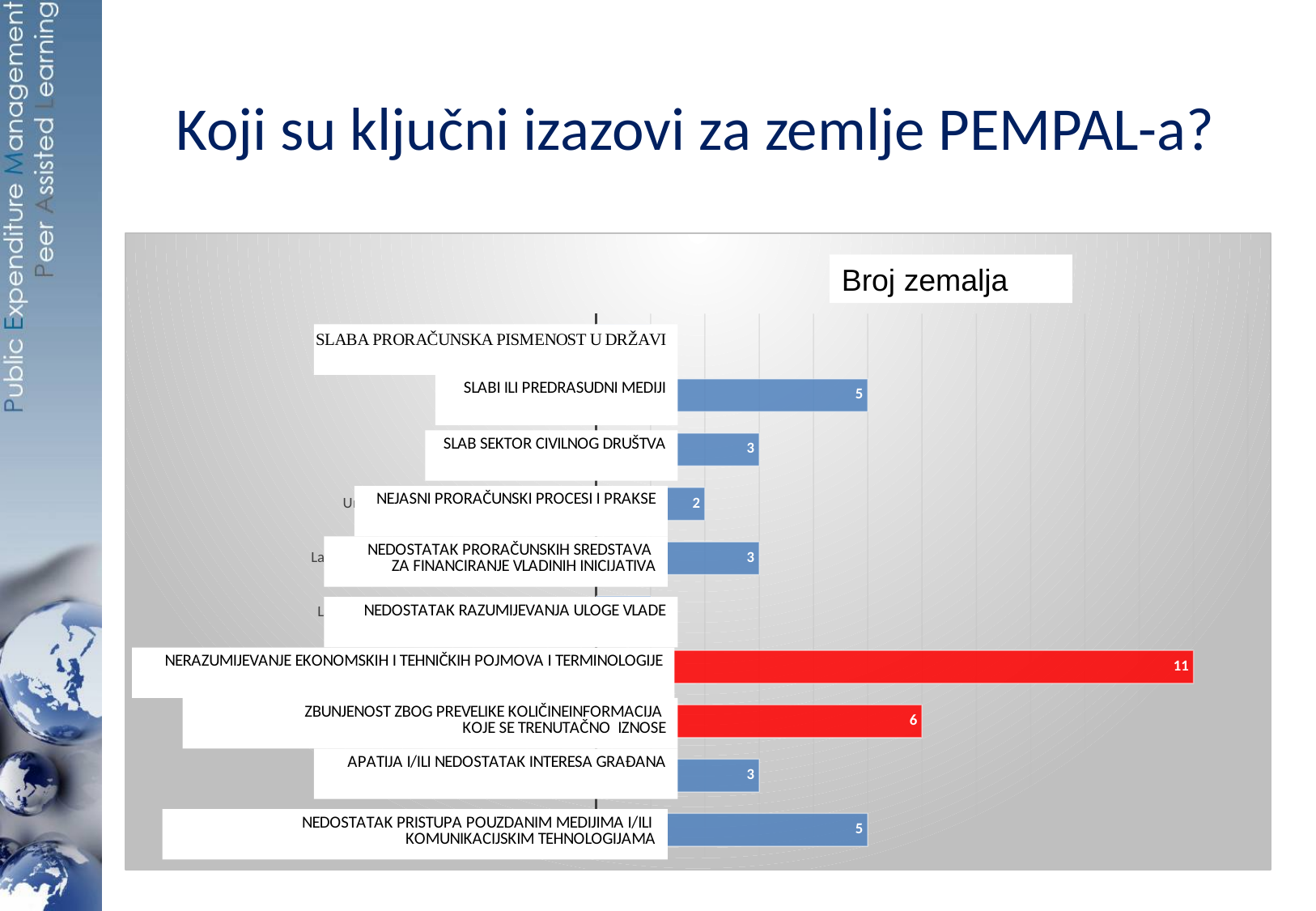
Which is larger, the value for NEDOSTATAK PRISTUPA POUZDANIM MEDIJIMA I/ILI KOMUNIKACIJSKIM TEHNOLOGIJAMA or the value for NEJASNI PRORAČUNSKI PROCESI I PRAKSE? NEDOSTATAK PRISTUPA POUZDANIM MEDIJIMA I/ILI KOMUNIKACIJSKIM TEHNOLOGIJAMA What kind of chart is shown on the slide? Bar chart Which category has the highest value? NERAZUMIJEVANJE EKONOMSKIH I TEHNIČKIH POJMOVA I TERMINOLOGIJE What is the value for APATIJA I/ILI NEDOSTATAK INTERESA GRAĐANA? 3 What is the difference between the values for SLABI ILI PREDRASUDNI MEDIJI and SLAB SEKTOR CIVILNOG DRUŠTVA? 2 What is the title of the chart? Broj zemalja What is the value for ZBUNJENOST ZBOG PREVELIKE KOLIČINE INFORMACIJA KOJE SE TRENUTAČNO IZNOSE? 6 What is the value for SLABI ILI PREDRASUDNI MEDIJI? 5 What is the value for NEJASNI PRORAČUNSKI PROCESI I PRAKSE? 2 What is the value for NERAZUMIJEVANJE EKONOMSKIH I TEHNIČKIH POJMOVA I TERMINOLOGIJE? 11 What is the difference between the values for NERAZUMIJEVANJE EKONOMSKIH I TEHNIČKIH POJMOVA I TERMINOLOGIJE and ZBUNJENOST ZBOG PREVELIKE KOLIČINE INFORMACIJA KOJE SE TRENUTAČNO IZNOSE? 5 How many categories are listed on the chart? 10